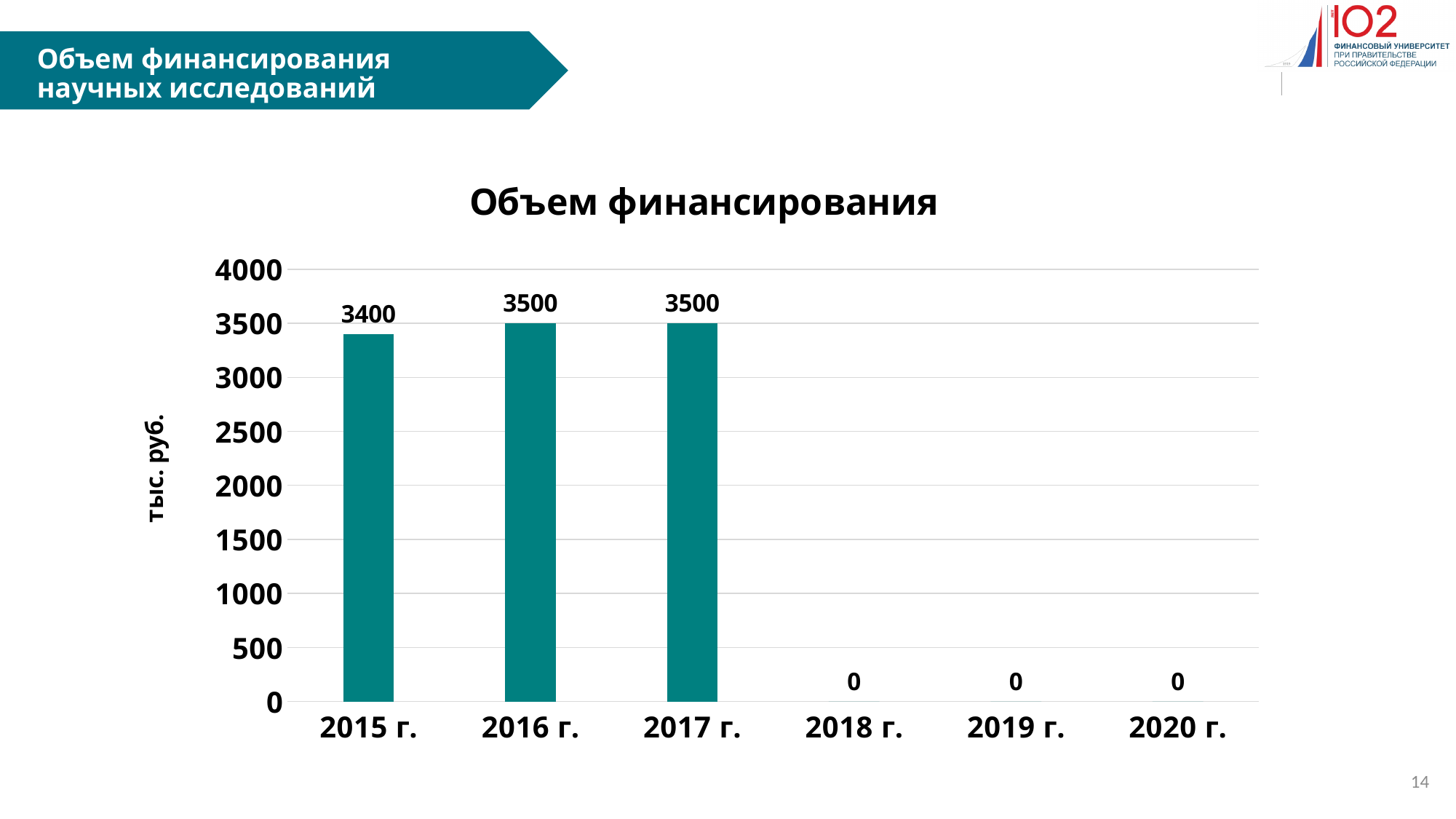
What is the title of the chart? Объем финансирования What is the difference between the values for 2016 г. and 2015 г.? 100 What is the value for 2015 г.? 3400 What is the value for 2019 г.? 0 What is the value for 2016 г.? 3500 What is the label of the vertical axis? тыс. руб. Is the value for 2015 г. greater or less than 3000? greater What kind of chart is shown? bar chart How many years are shown on the x axis? 6 Which is larger, the value for 2015 г. or the value for 2017 г.? 2017 г. How many years have a value of 0? 3 Which year has the lowest value among 2015 г., 2016 г. and 2017 г.? 2015 г.